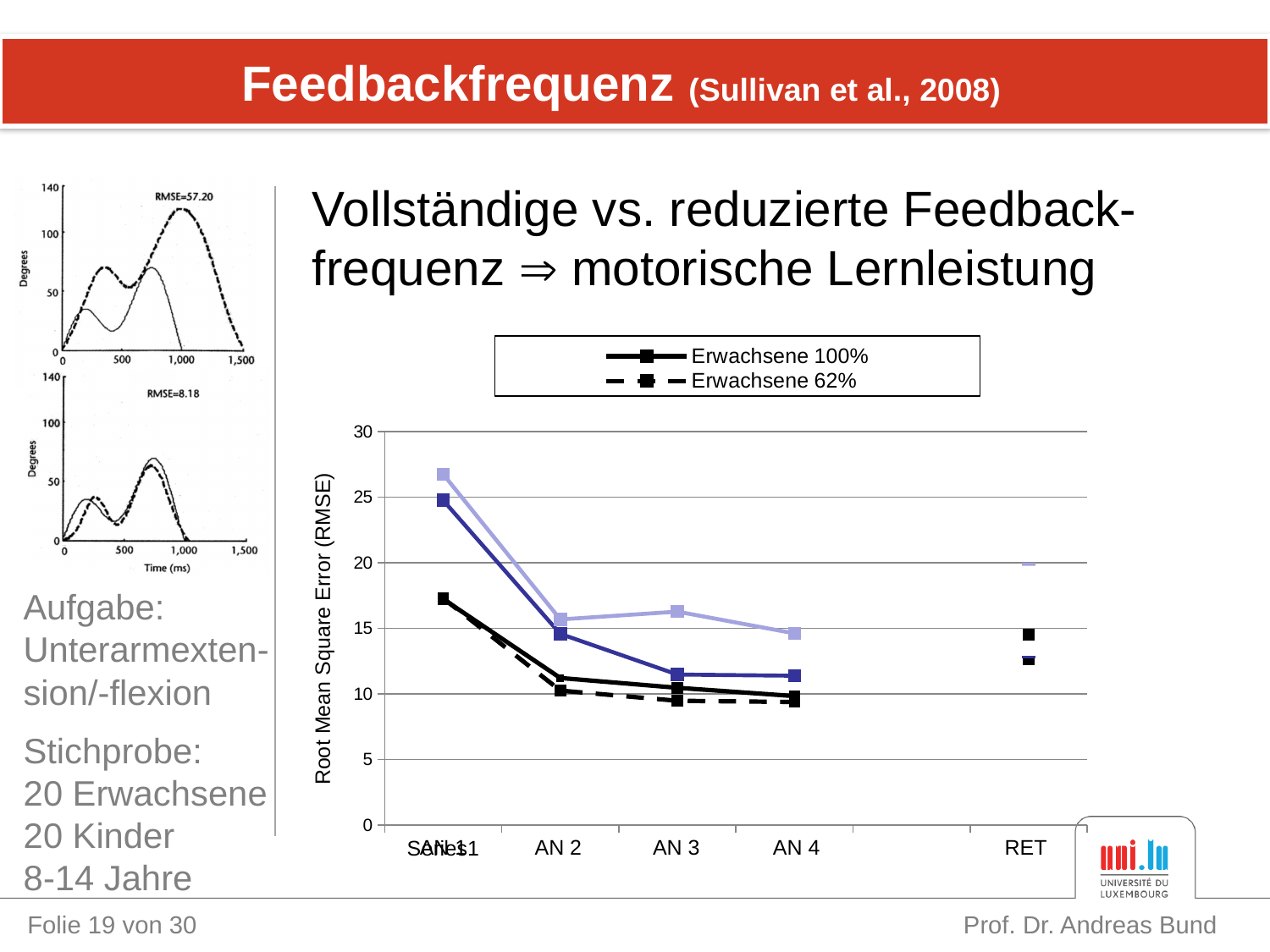
In the main chart, is the value for Erwachsene 100% at AN 3 greater or less than 5? greater How many series does the legend of the main chart list? 2 In the main chart, at AN 3, which series has the higher value: Erwachsene 100% or Erwachsene 62%? Erwachsene 100% What RMSE value is printed on the top-left chart? RMSE=57.20 What is the y-axis title of the main chart? Root Mean Square Error (RMSE) In the main chart, does the Erwachsene 100% line rise or fall from AN 2 to AN 4? fall In the main chart, at which x-axis category does the Erwachsene 100% line reach its lowest value among AN 2, AN 3 and AN 4? AN 4 What kind of chart is the main chart on the right of the slide? line chart In the main chart, is the value for Erwachsene 62% at AN 4 greater or less than 15? less What RMSE value is printed on the bottom-left chart? RMSE=8.18 In the main chart, is the value for Erwachsene 100% at AN 2 greater or less than 15? less What are the two entries in the legend of the main chart? Erwachsene 100% and Erwachsene 62%